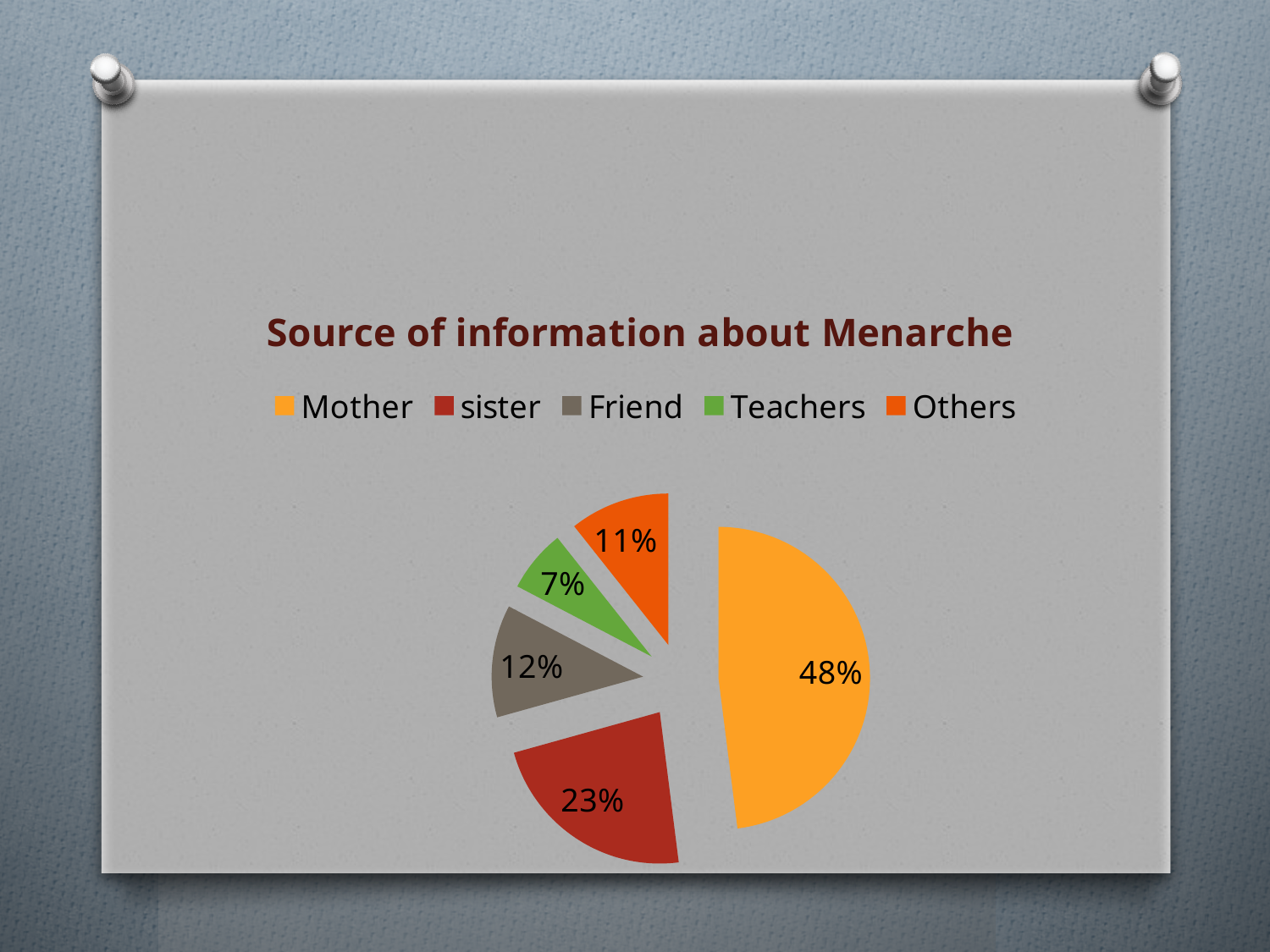
Which source has the largest share of the pie? Mother What percentage of the pie is labelled for Others? 11% What percentage of the pie is labelled for Friend? 12% What percentage of the pie is labelled for Mother? 48% How many categories does the legend list? 5 Which slice is larger, Friend or Others? Friend What type of chart is shown on the slide? Pie chart Which source has the smallest share of the pie? Teachers What is the difference in percentage points between the Mother and sister slices? 25 What percentage of the pie is labelled for Teachers? 7% What percentage of the pie is labelled for sister? 23% What is the title of the pie chart? Source of information about Menarche